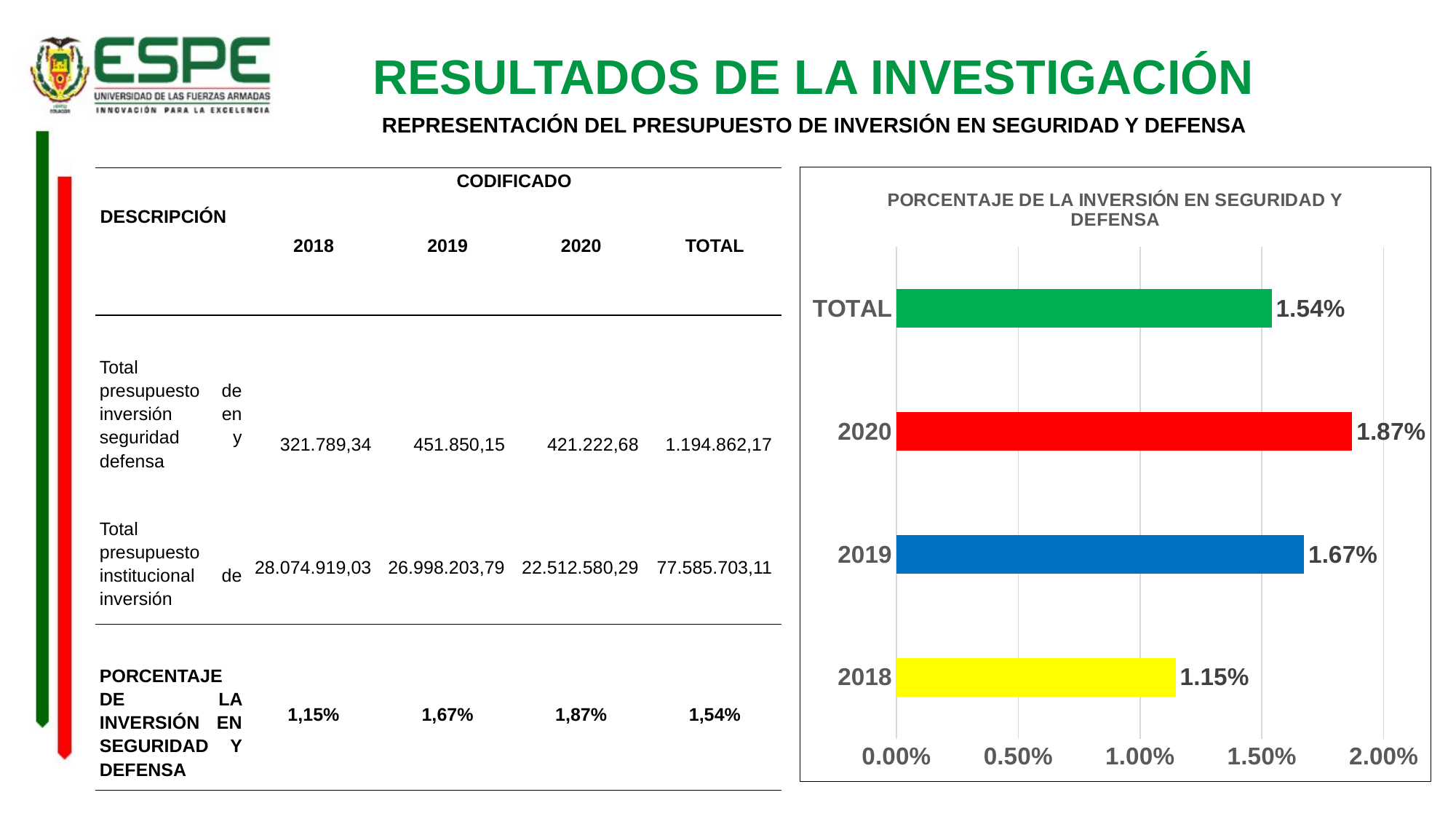
What is the difference between the values for 2020 and 2018? 0.72% What is the value for 2018 in the chart? 1.15% Which category has the lowest value in the chart? 2018 What is the title of the chart? PORCENTAJE DE LA INVERSIÓN EN SEGURIDAD Y DEFENSA How many bars are shown in the chart? 4 Which category has the highest value in the chart? 2020 Is the value for 2018 greater or less than 1.00%? greater Which is larger, the value for 2019 or the value for TOTAL? 2019 What is the value for 2019 in the chart? 1.67% What is the value for 2020 in the chart? 1.87% What is the value for TOTAL in the chart? 1.54% What kind of chart is shown on the slide? Bar chart